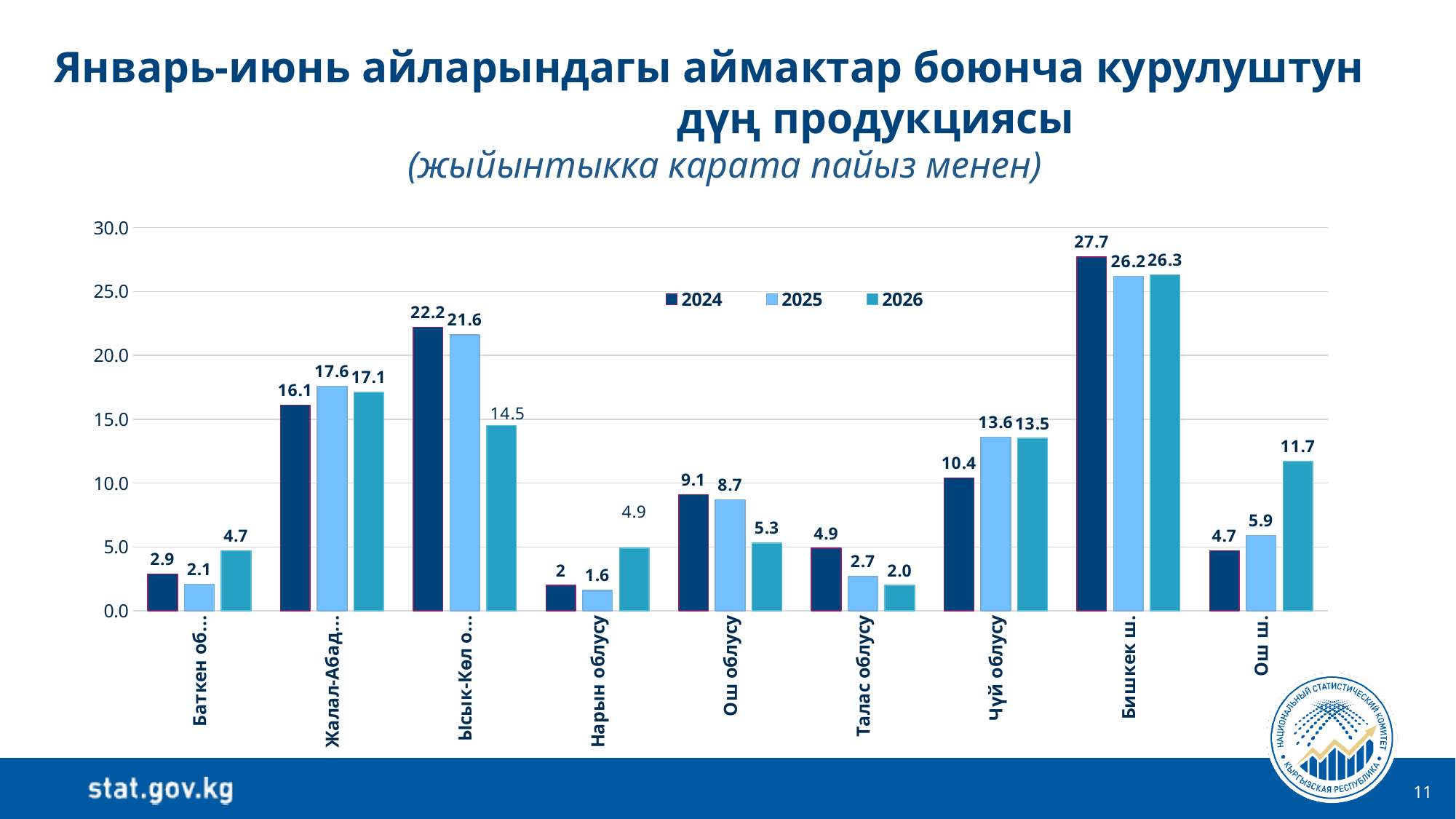
What is the 2024 value for Бишкек ш.? 27.7 Which is larger for Ош облусу: the 2024 value or the 2026 value? 2024 What is the 2026 value for Нарын облусу? 4.9 Which series is shown in the darkest blue colour in the legend? 2024 What is the difference between the 2024 and 2026 values for Талас облусу? 2.9 Which category has the highest 2024 value? Бишкек ш. What is the 2025 value for Чүй облусу? 13.6 Is the 2025 value for Чүй облусу greater or less than 10.0? greater What kind of chart is shown on the slide? bar chart How many series does the legend list? 3 Which category has the lowest 2025 value? Нарын облусу How many categories are shown on the x axis? 9